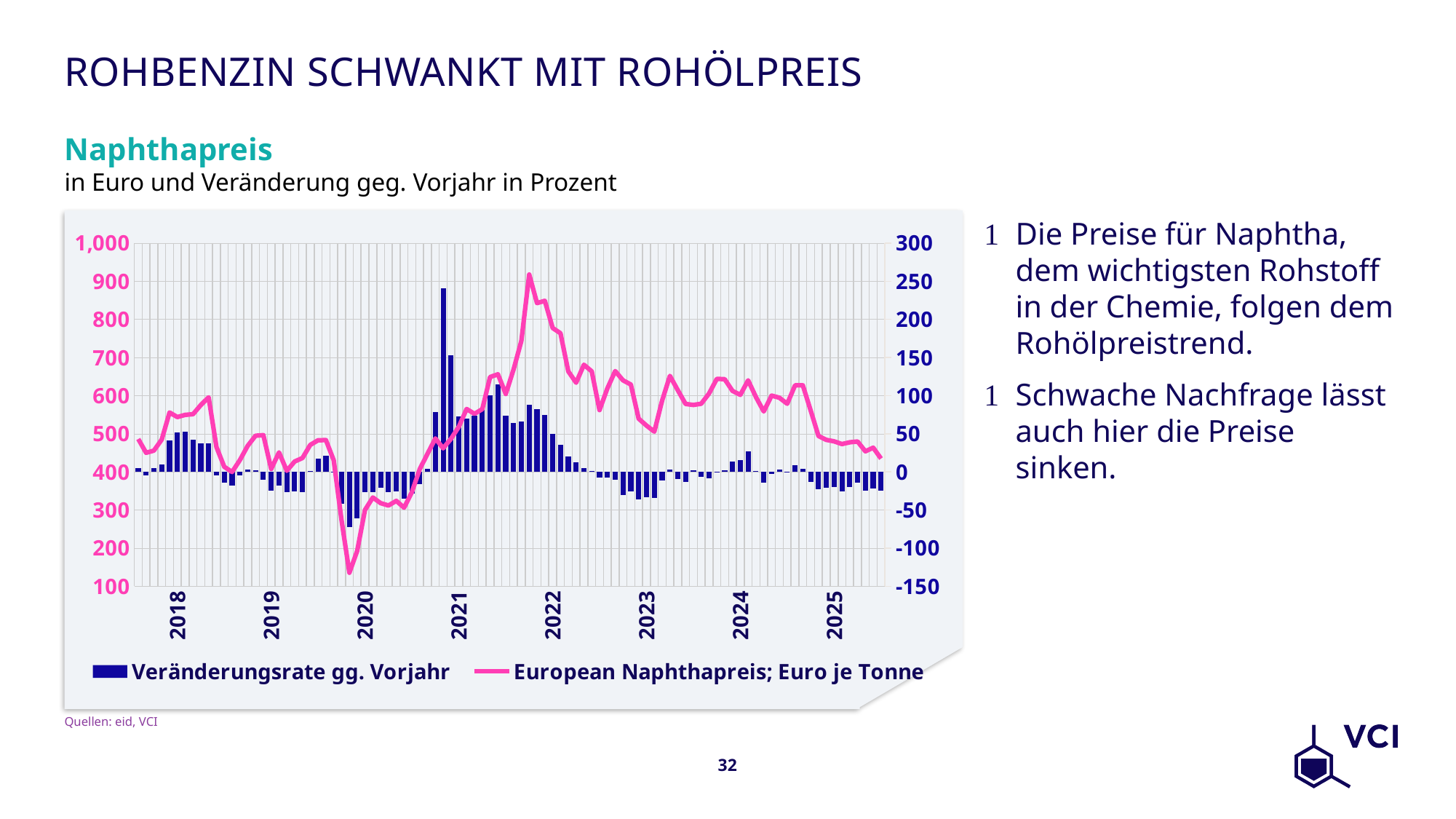
Is the lowest value of the European Naphthapreis line in 2020 greater or less than 200? less In which year does the European Naphthapreis line reach its highest point? 2022 Is the peak value of the European Naphthapreis line in 2022 greater or less than 800? greater What kind of chart is shown on the slide? A combined bar and line chart Is the European Naphthapreis line higher at its 2022 peak or at its 2018 peak? 2022 peak Is the tallest Veränderungsrate gg. Vorjahr bar, in 2021, greater or less than 200 on the right axis? greater How many series does the chart legend list? 2 How many years are labelled on the x axis of the chart? 8 Does the European Naphthapreis line rise or fall between its 2022 peak and the end of 2025? fall In which year does the European Naphthapreis line reach its lowest point? 2020 Which series is drawn as a line in the chart? European Naphthapreis; Euro je Tonne Which series is drawn as bars in the chart? Veränderungsrate gg. Vorjahr